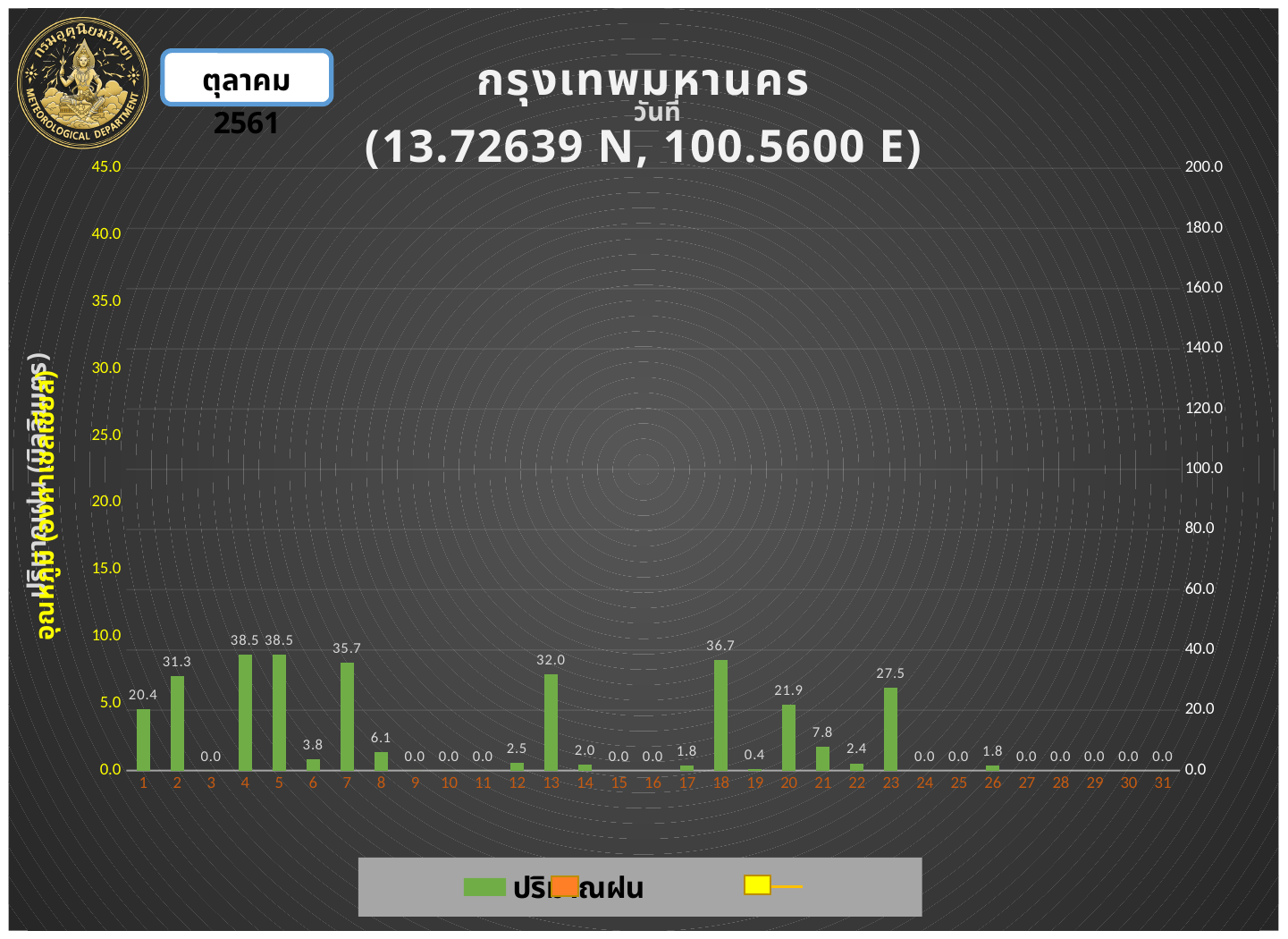
How many days are shown on the x axis of the chart? 31 What is the value shown for day 6? 3.8 What is the difference between the values for day 18 and day 13? 4.7 What kind of chart is shown on the slide? Bar chart What is the value shown for day 23? 27.5 What is the value shown for day 18? 36.7 Which day has the larger value, day 20 or day 21? Day 20 What is the difference between the values for day 7 and day 1? 15.3 What is the main title of the chart? กรุงเทพมหานคร (13.72639 N, 100.5600 E) What is the value shown for day 13? 32.0 What is the highest value plotted in the chart? 38.5 What is the value shown for day 2? 31.3